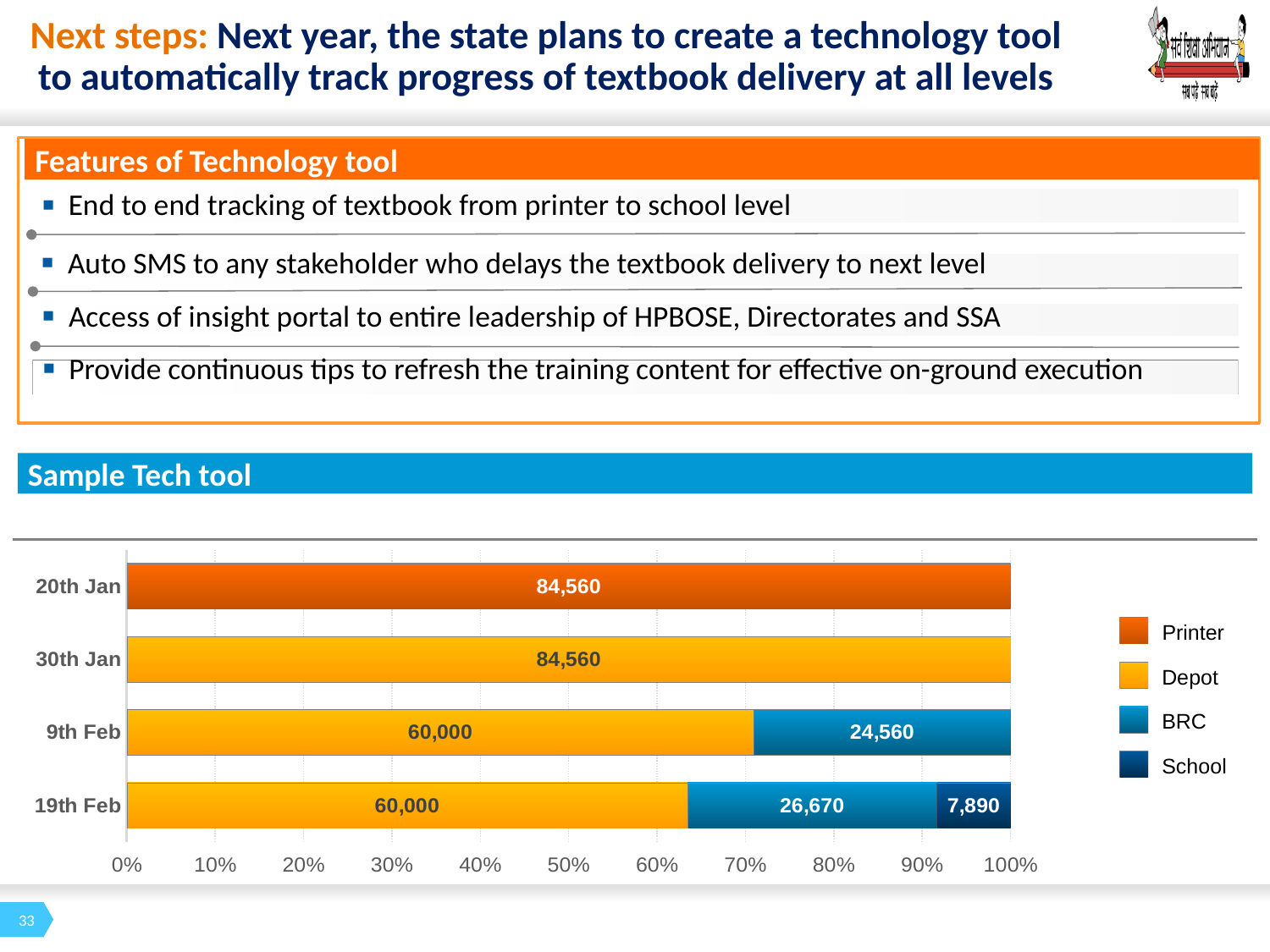
What is the difference between the BRC values for 19th Feb and 9th Feb? 2,110 What is the Printer value for 20th Jan? 84,560 How many dates are shown on the vertical axis of the chart? 4 Which series is shown in the darkest blue colour in the legend? School What is the total of the 19th Feb bar (Depot + BRC + School)? 94,560 What is the BRC value for 19th Feb? 26,670 What kind of chart is shown under "Sample Tech tool"? bar chart What is the School value for 19th Feb? 7,890 What is the BRC value for 9th Feb? 24,560 Which is larger on 19th Feb, the Depot value or the BRC value? Depot What is the Depot value for 30th Jan? 84,560 How many series does the legend list? 4